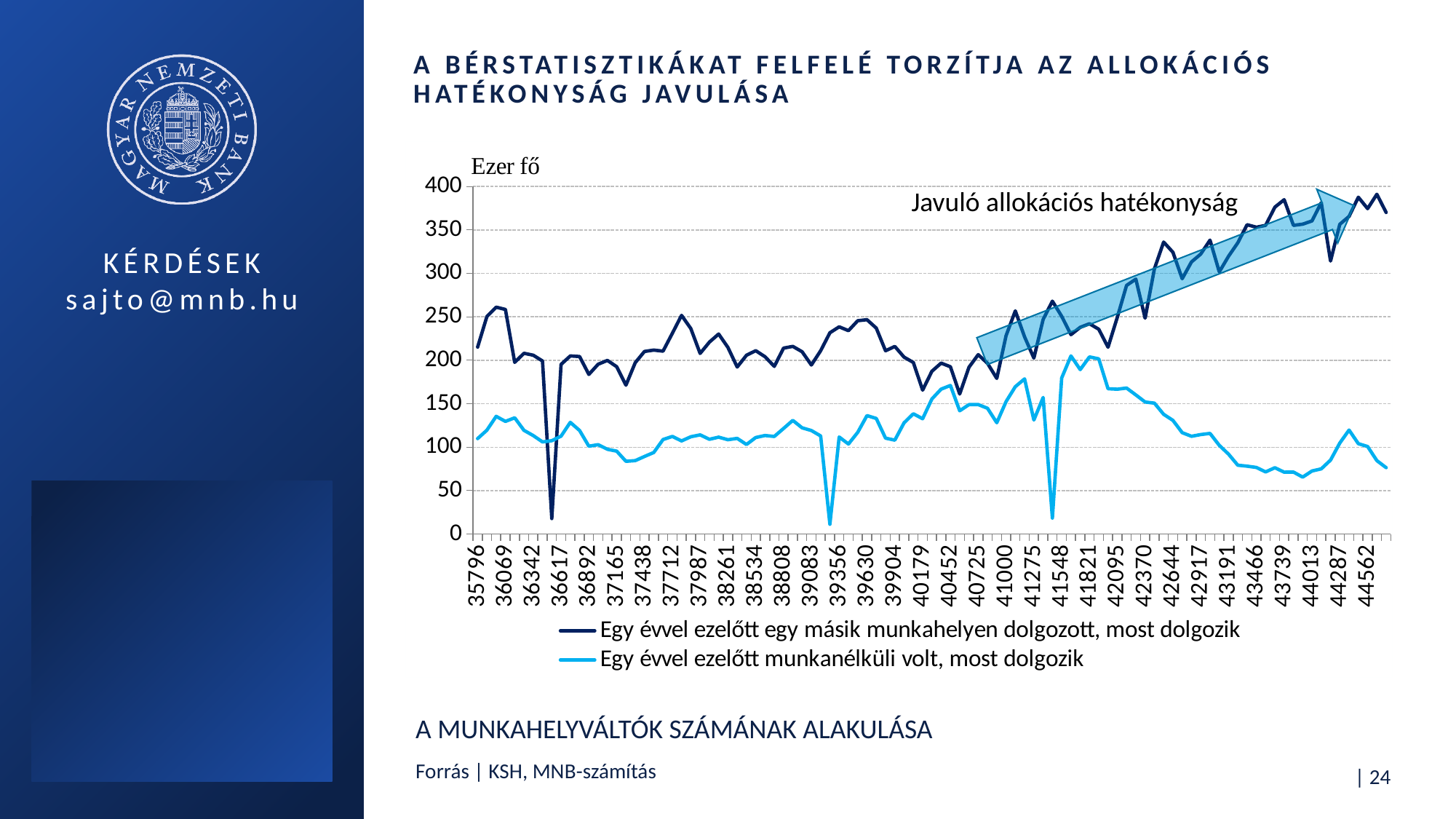
Is the value of 'Egy évvel ezelőtt egy másik munkahelyen dolgozott, most dolgozik' at 44562 greater or less than 350? greater What text is written next to the arrow annotation on the chart? Javuló allokációs hatékonyság Is the value of 'Egy évvel ezelőtt egy másik munkahelyen dolgozott, most dolgozik' at 35796 greater or less than 200? greater What is the first legend entry of the chart? Egy évvel ezelőtt egy másik munkahelyen dolgozott, most dolgozik At 35796, which series has the higher value? Egy évvel ezelőtt egy másik munkahelyen dolgozott, most dolgozik What kind of chart is shown on the slide? line chart Does the series 'Egy évvel ezelőtt egy másik munkahelyen dolgozott, most dolgozik' rise or fall overall from the start to the end of the x axis? rise At 44562, which series has the higher value? Egy évvel ezelőtt egy másik munkahelyen dolgozott, most dolgozik Does the series 'Egy évvel ezelőtt munkanélküli volt, most dolgozik' rise or fall from 41548 to the end of the x axis? fall Is the value of 'Egy évvel ezelőtt munkanélküli volt, most dolgozik' at 35796 greater or less than 150? less How many series does the legend list? 2